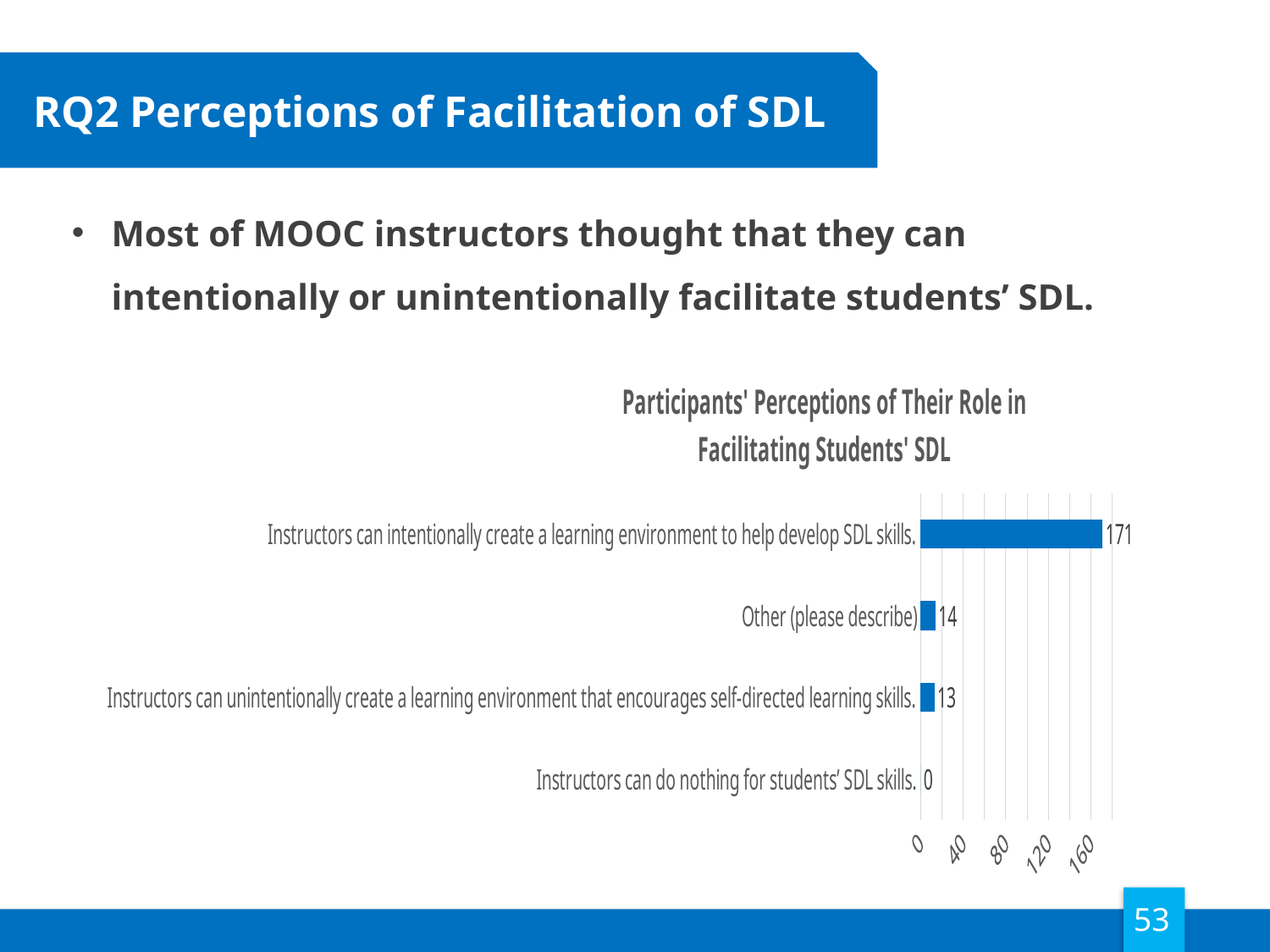
What is the title of the chart? Participants' Perceptions of Their Role in Facilitating Students' SDL What is the difference between the value for "Instructors can intentionally create a learning environment to help develop SDL skills." and the value for "Other (please describe)"? 157 What is the value for "Instructors can intentionally create a learning environment to help develop SDL skills."? 171 What is the value for "Instructors can unintentionally create a learning environment that encourages self-directed learning skills."? 13 Which category has the highest value? Instructors can intentionally create a learning environment to help develop SDL skills. What is the value for "Other (please describe)"? 14 What is the value for "Instructors can do nothing for students' SDL skills."? 0 Which category has the lowest value? Instructors can do nothing for students' SDL skills. How many categories are shown in the chart? 4 What kind of chart is shown on the slide? bar chart What is the difference between the value for "Other (please describe)" and the value for "Instructors can unintentionally create a learning environment that encourages self-directed learning skills."? 1 Is the value for "Instructors can intentionally create a learning environment to help develop SDL skills." greater or less than 160? greater